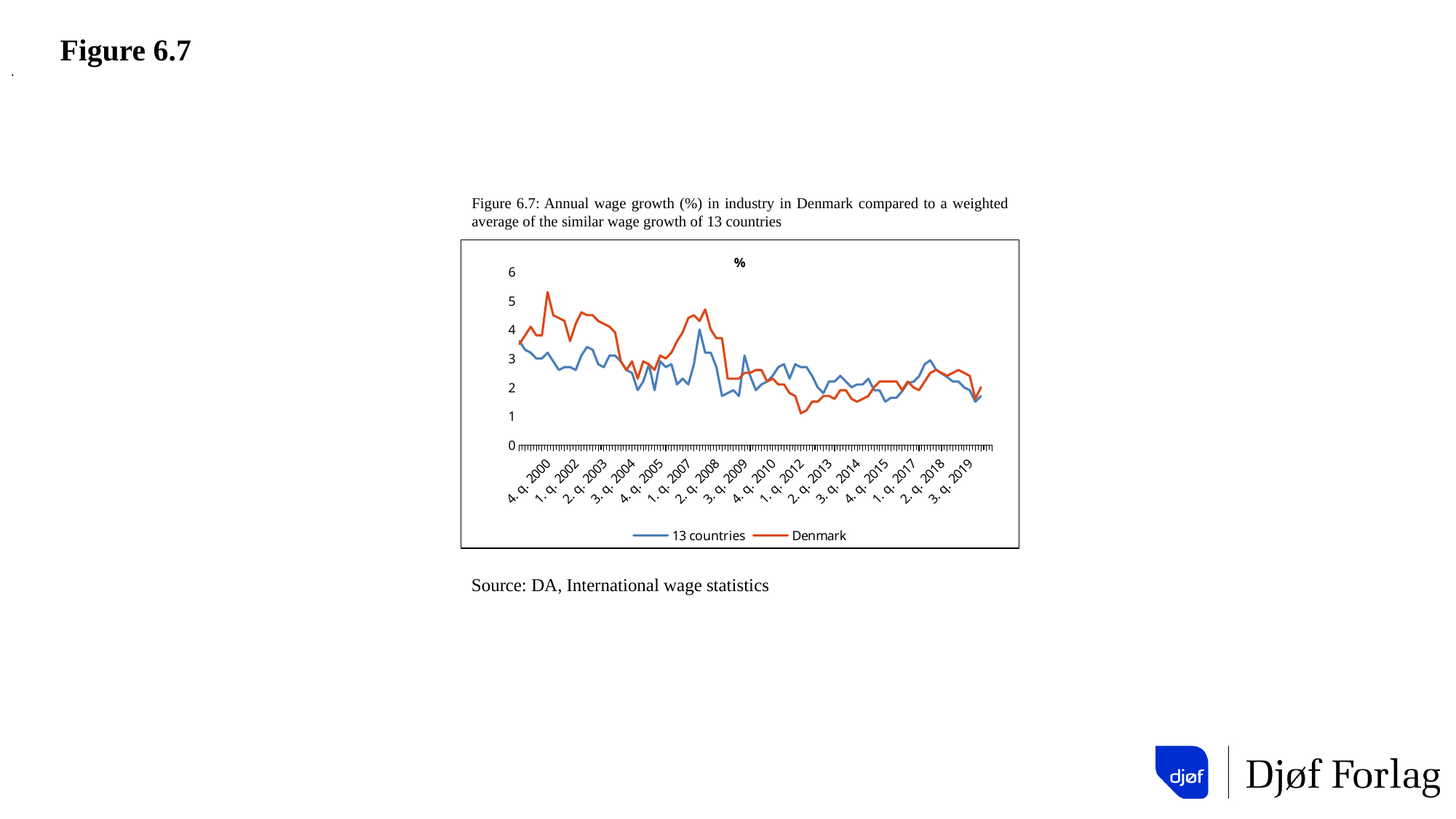
Overall, do the wage growth values rise or fall from 2000 to 2019? fall How many series does the chart's legend list? 2 Which series reaches the highest value anywhere on the chart? Denmark Around 2. q. 2002, which series has the higher value, Denmark or 13 countries? Denmark Is the peak value of the Denmark series around 2001 greater or less than 5? greater What kind of chart is shown on the slide? line chart Around 1. q. 2012, which series has the higher value, Denmark or 13 countries? 13 countries What is the highest value shown on the vertical axis? 6 Which series is drawn in orange? Denmark Is the lowest value of the Denmark series, around 2012, greater or less than 2? less What are the two series named in the chart's legend? 13 countries and Denmark